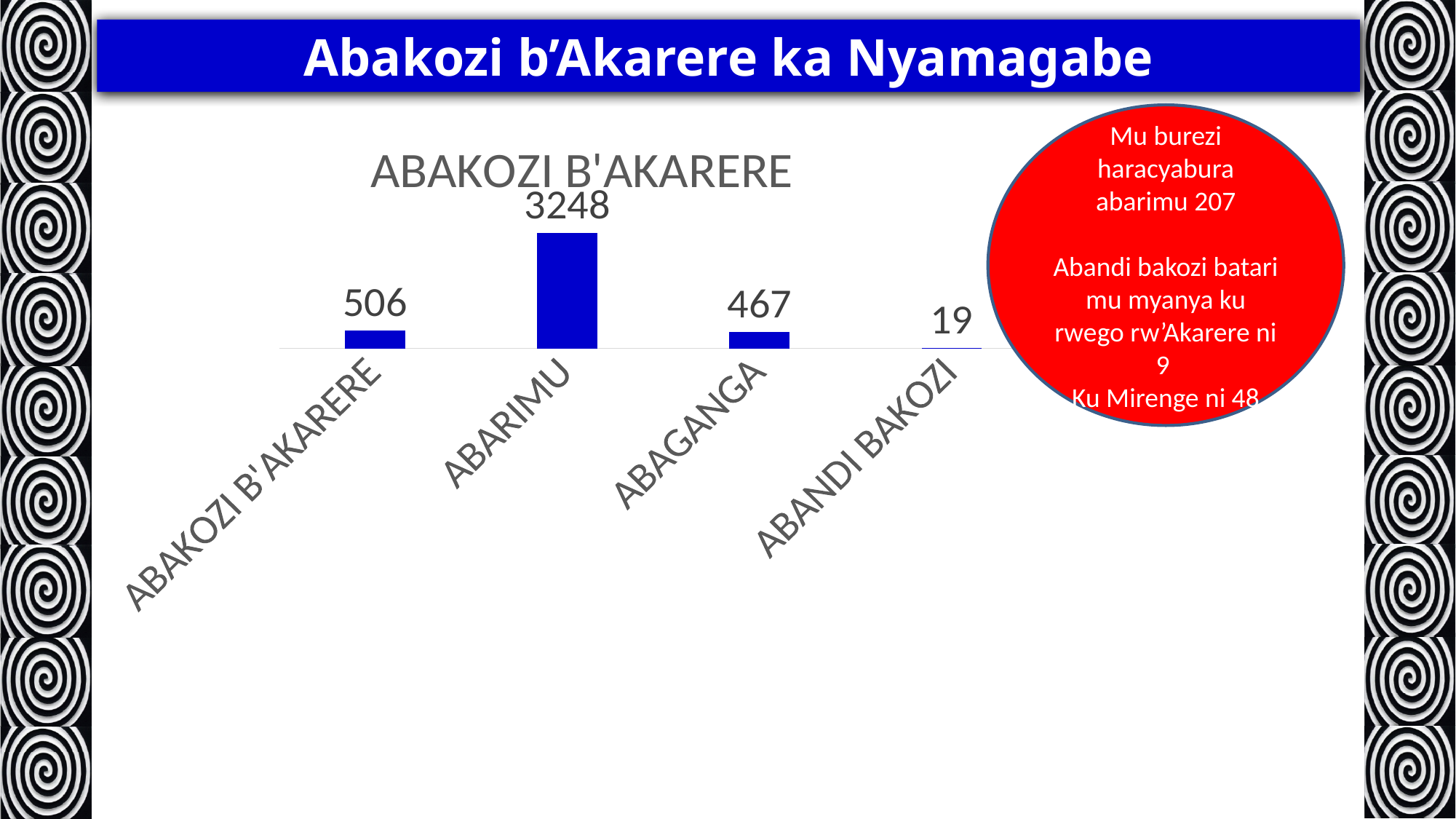
What is the value for ABAGANGA? 467 How many categories are shown in the chart? 4 What is the value for ABANDI BAKOZI? 19 What kind of chart is shown on the slide? bar chart What is the value for ABAKOZI B'AKARERE? 506 What is the difference between the values for ABARIMU and ABAKOZI B'AKARERE? 2742 Which category has the lowest value? ABANDI BAKOZI Which category has the highest value? ABARIMU What is the title of the chart? ABAKOZI B'AKARERE Which is larger, the value for ABAKOZI B'AKARERE or the value for ABAGANGA? ABAKOZI B'AKARERE What is the value for ABARIMU? 3248 What is the difference between the values for ABAKOZI B'AKARERE and ABAGANGA? 39